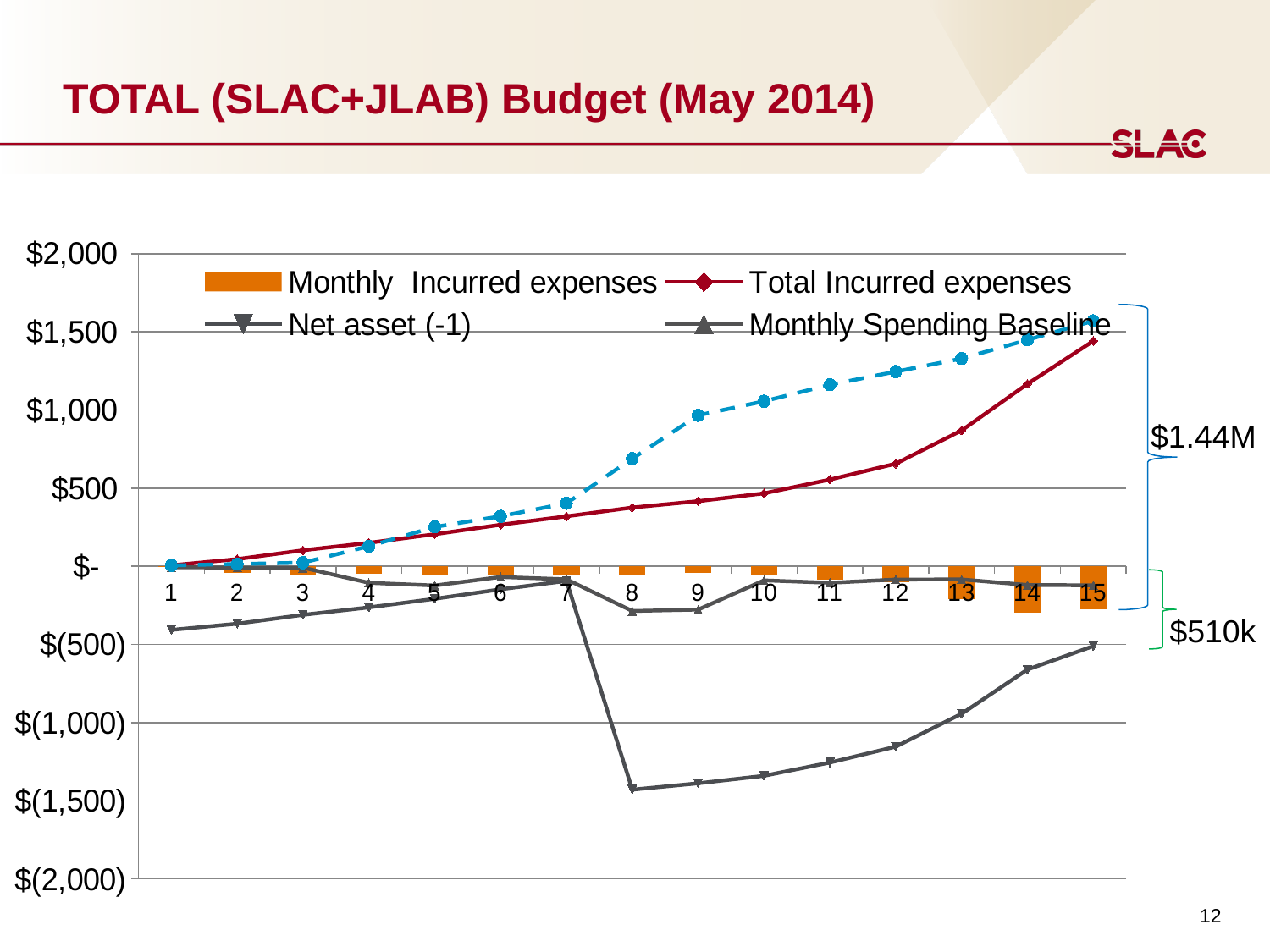
Is the Total Incurred expenses value at point 9 greater or less than $500? less How many points are shown along the x axis of the chart? 15 Which colour represents Monthly Incurred expenses in the legend? Orange How many series does the chart legend list? 4 Is the Total Incurred expenses value at point 15 greater or less than $1,000? greater At which x-axis point does the Net asset (-1) series reach its lowest value? 8 Is the Net asset (-1) value at point 8 greater or less than $(1,000)? less At which x-axis point does the Total Incurred expenses series reach its highest value? 15 Does the Total Incurred expenses line rise or fall from point 1 to point 15? Rises What is the title of the chart on this slide? TOTAL (SLAC+JLAB) Budget (May 2014) What kind of chart is shown on the slide? Combined bar and line chart